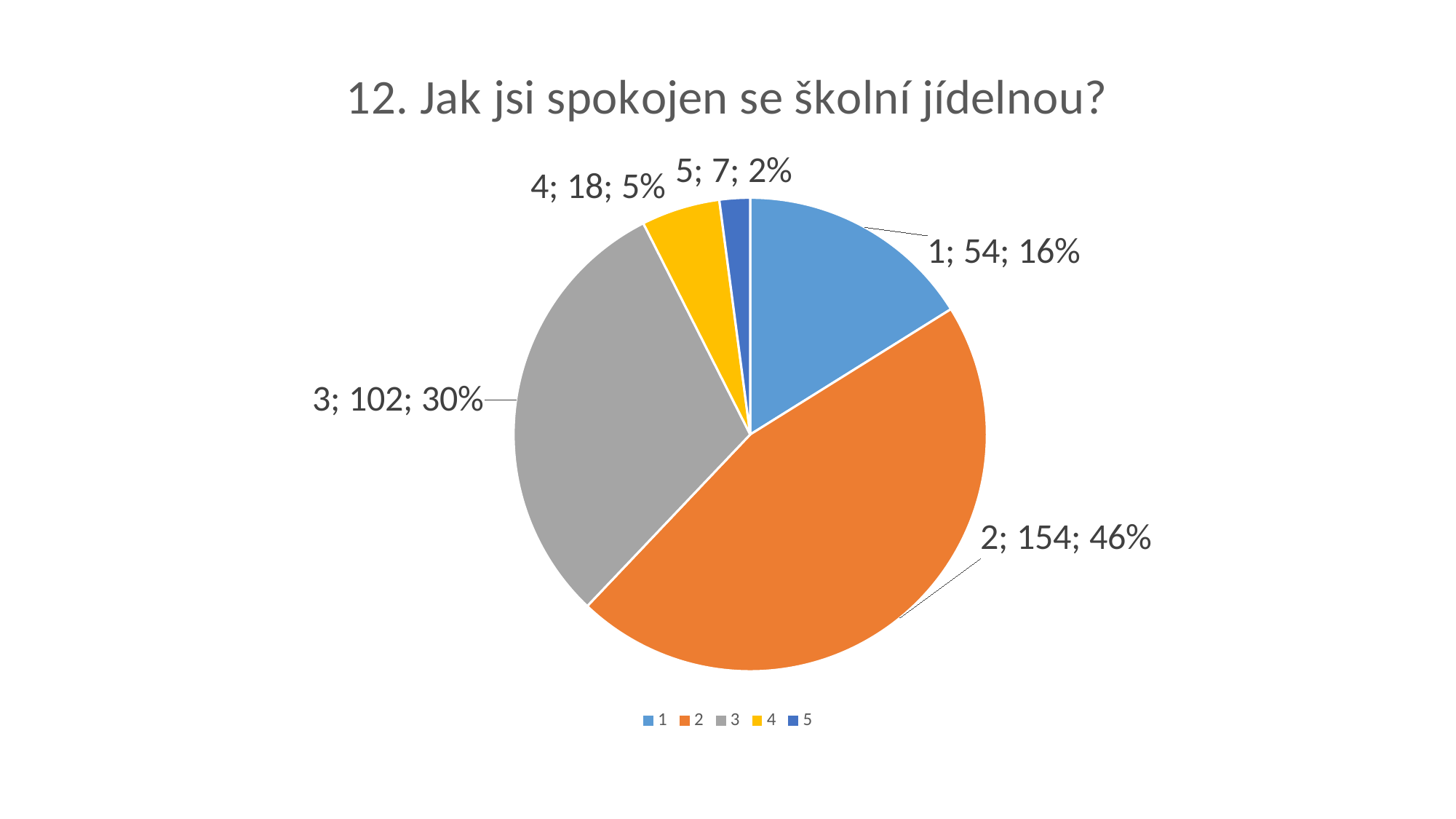
Which is larger, the value for category 1 or the value for category 4? 1 What share of the pie does category 1 represent? 16% What is the value for category 2? 154 How many slices does the pie chart have? 5 What kind of chart is shown on the slide? pie chart What is the value for category 3? 102 What is the difference between the values for category 2 and category 3? 52 What is the value for category 5? 7 Which category has the largest slice? 2 What share of the pie does category 4 represent? 5% Which category has the smallest slice? 5 What is the title of the chart? 12. Jak jsi spokojen se školní jídelnou?